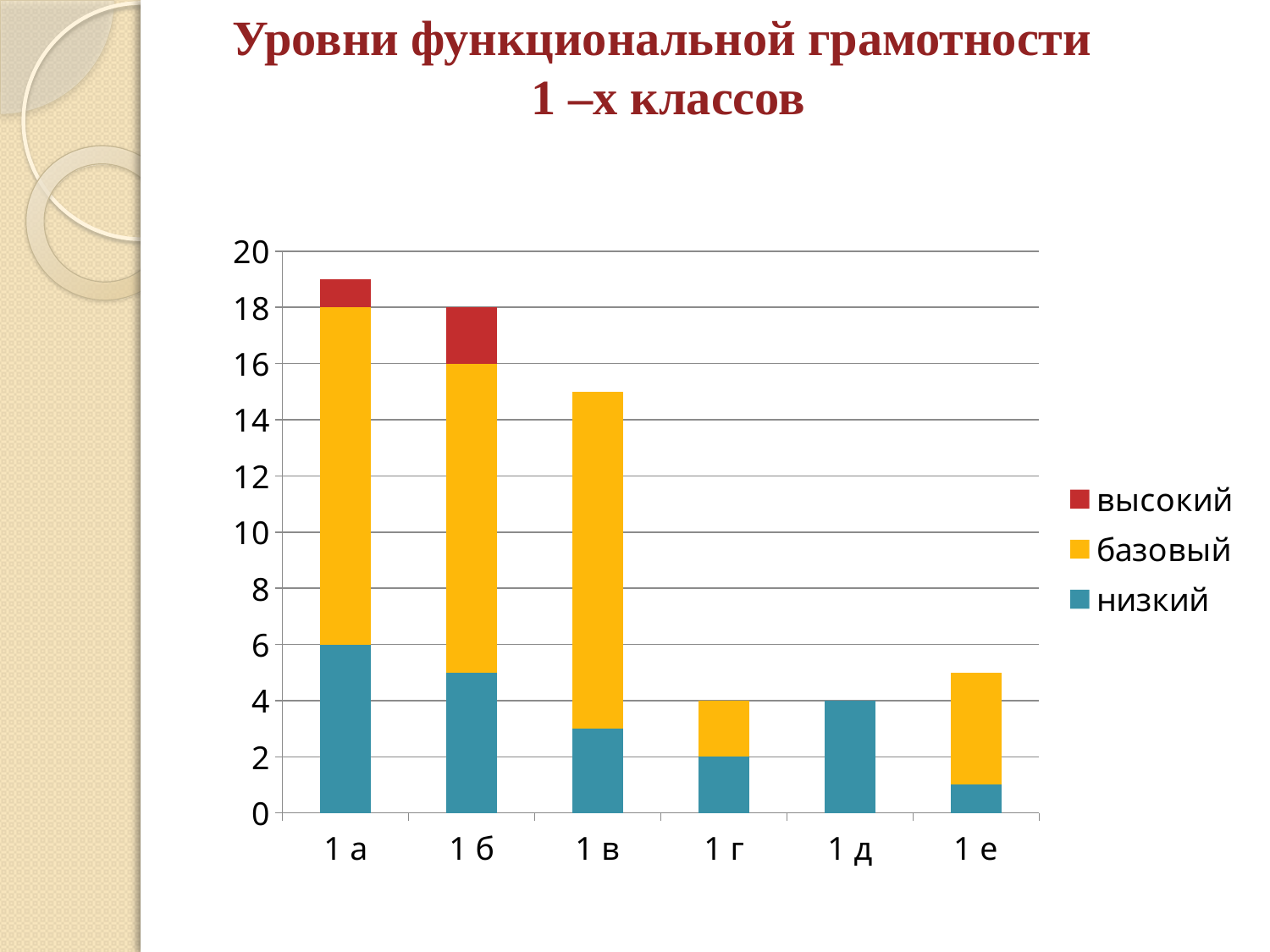
Is the total for class 1 в greater or less than 16? less How many classes (categories) are shown on the x axis? 6 What is the total height of the stacked bar for class 1 г? 4 Which class has the tallest stacked bar overall? 1 а What is the difference between the total for class 1 б and the total for class 1 г? 14 What is the total height of the stacked bar for class 1 б? 18 Which class has the larger total bar, 1 в or 1 е? 1 в What is the value of the низкий segment for class 1 д? 4 What type of chart is shown on the slide? stacked bar chart What is the value of the низкий segment for class 1 а? 6 How many series does the legend list? 3 Which class has the smallest низкий segment? 1 е